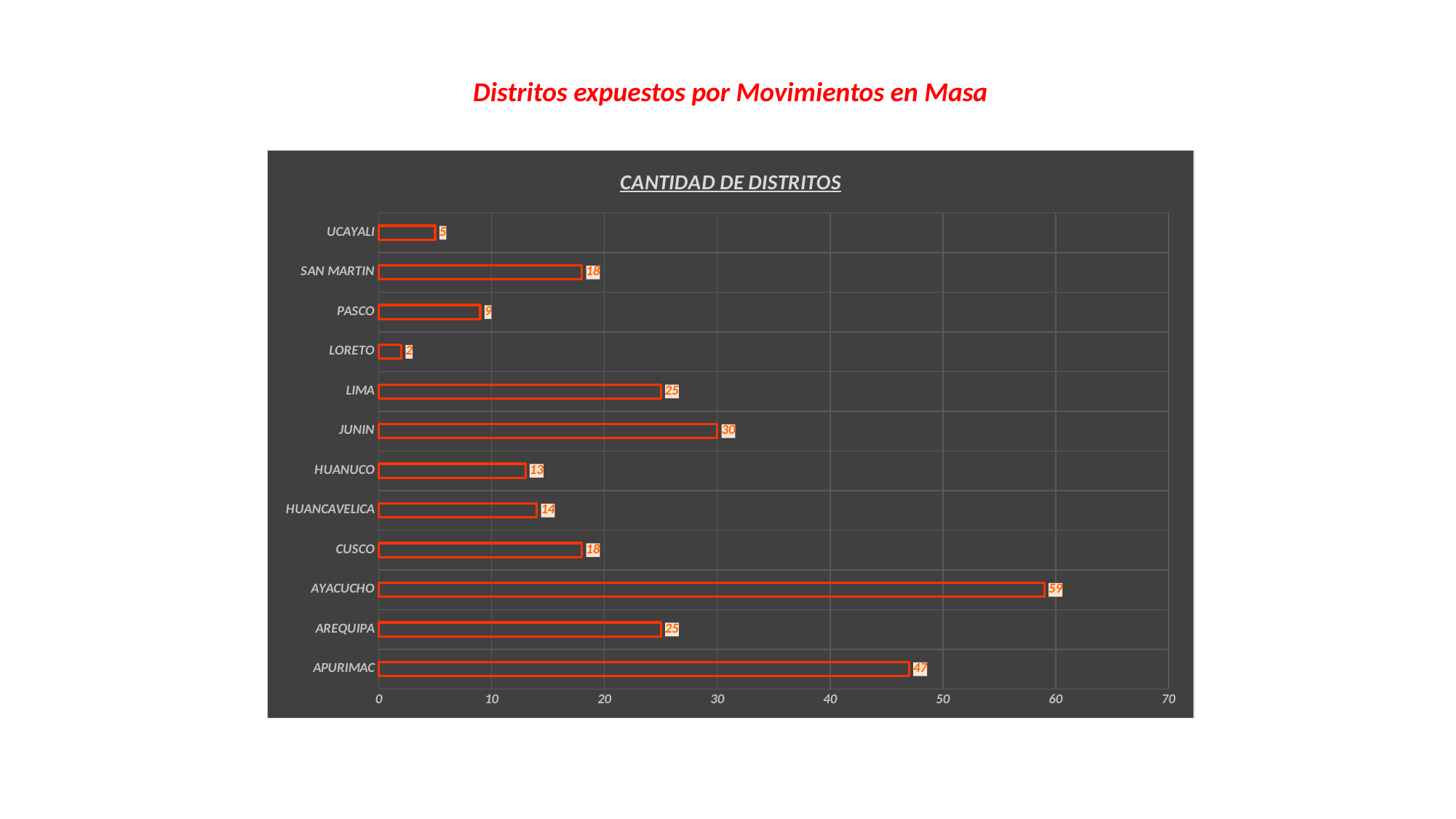
How many categories are shown in the chart? 12 What is the value for LORETO? 2 Which is larger, the value for LIMA or the value for HUANUCO? LIMA What is the title of the chart? CANTIDAD DE DISTRITOS What is the difference between the values for AYACUCHO and APURIMAC? 12 Is the value for APURIMAC greater or less than 40? greater What is the value for JUNIN? 30 What is the value for AYACUCHO? 59 Which category has the highest value? AYACUCHO Which category has the lowest value? LORETO What kind of chart is shown on the slide? Bar chart What is the difference between the values for SAN MARTIN and PASCO? 9